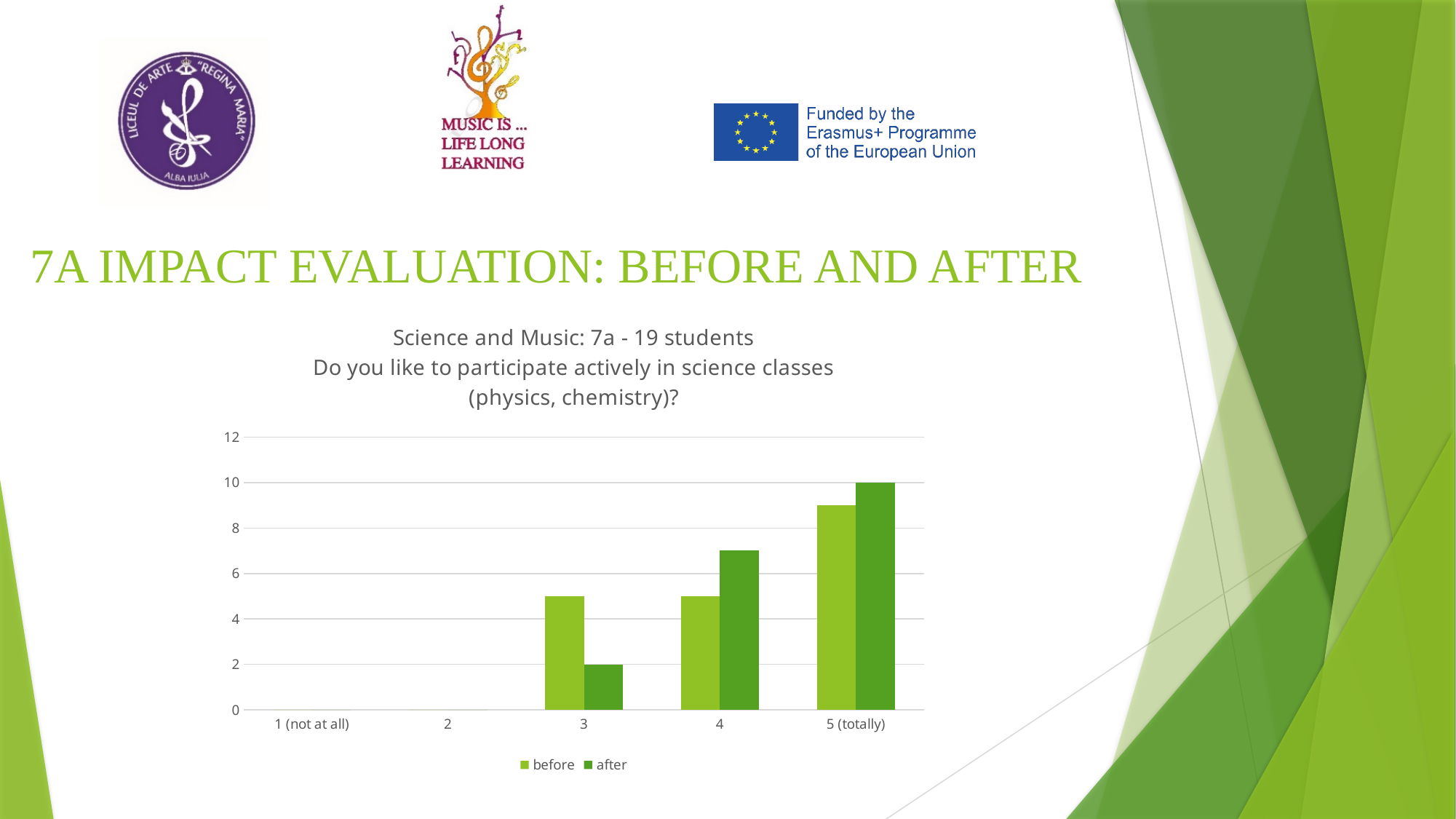
Which category has the highest value in the 'before' series? 5 (totally) What type of chart is shown on the slide? bar chart Do the 'after' values rise or fall from category 3 to category '5 (totally)'? rise What is the value of the 'after' series for category '5 (totally)'? 10 For category 4, which is larger: the 'before' value or the 'after' value? after How many categories are shown on the x axis? 5 How many series does the legend list? 2 Is the 'before' value for category '5 (totally)' greater or less than 8? greater What is the value of the 'after' series for category 3? 2 Which category has the highest value in the 'after' series? 5 (totally) What are the two series named in the legend? before and after For category 3, which is larger: the 'before' value or the 'after' value? before